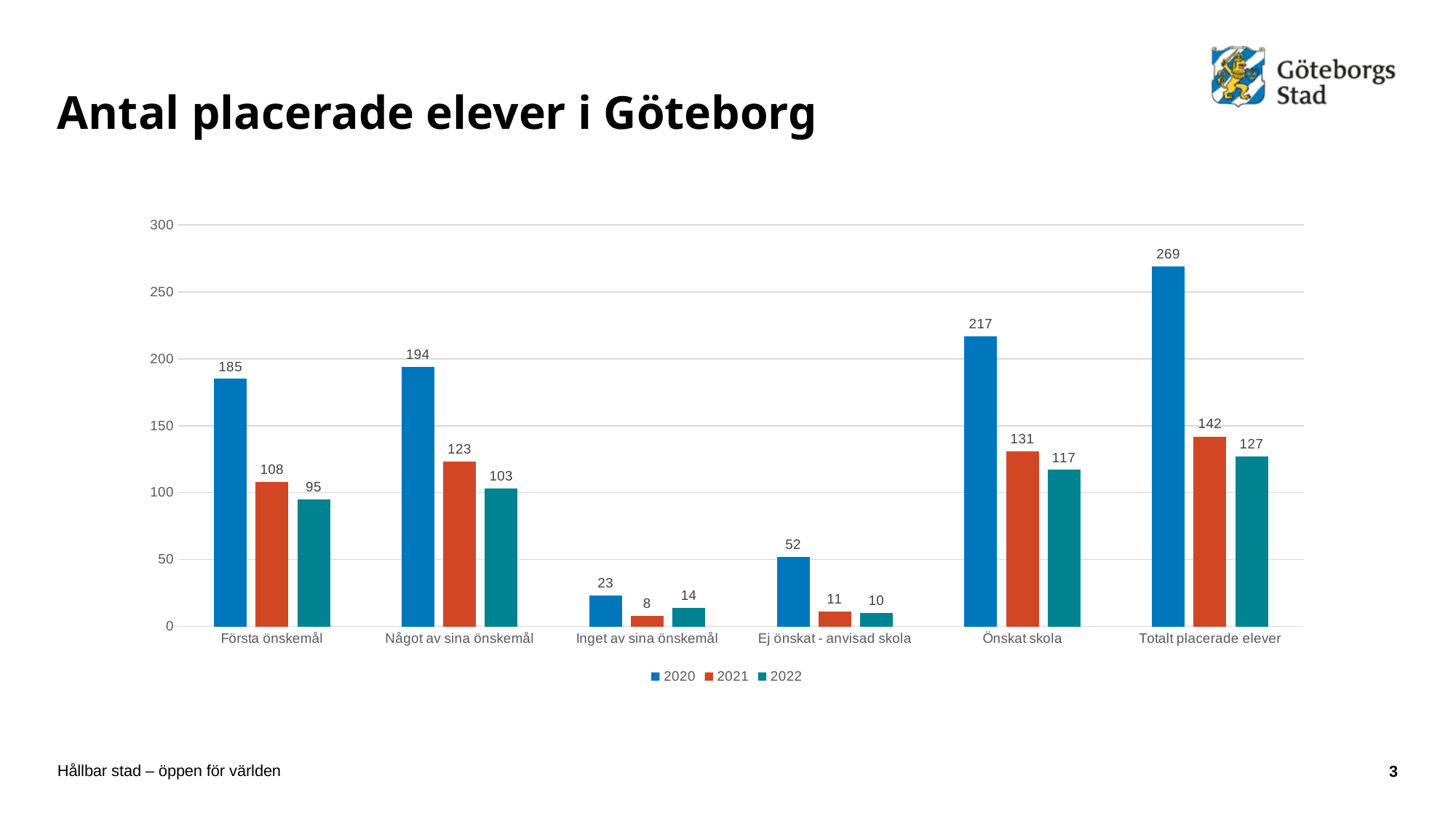
Is the value for 2020 in Ej önskat - anvisad skola greater or less than 100? less Which category has the lowest value for the 2022 series? Ej önskat - anvisad skola Which is larger in the Något av sina önskemål category: the 2021 value or the 2022 value? 2021 What is the value for 2021 in the Inget av sina önskemål category? 8 How many categories are shown on the x axis? 6 How many series does the legend list? 3 What kind of chart is shown on the slide? bar chart What is the difference between the 2020 and 2021 values for Önskat skola? 86 What is the value for 2022 in the Totalt placerade elever category? 127 Which category has the highest value for the 2020 series? Totalt placerade elever What is the value for 2020 in the Första önskemål category? 185 What is the title of the slide? Antal placerade elever i Göteborg